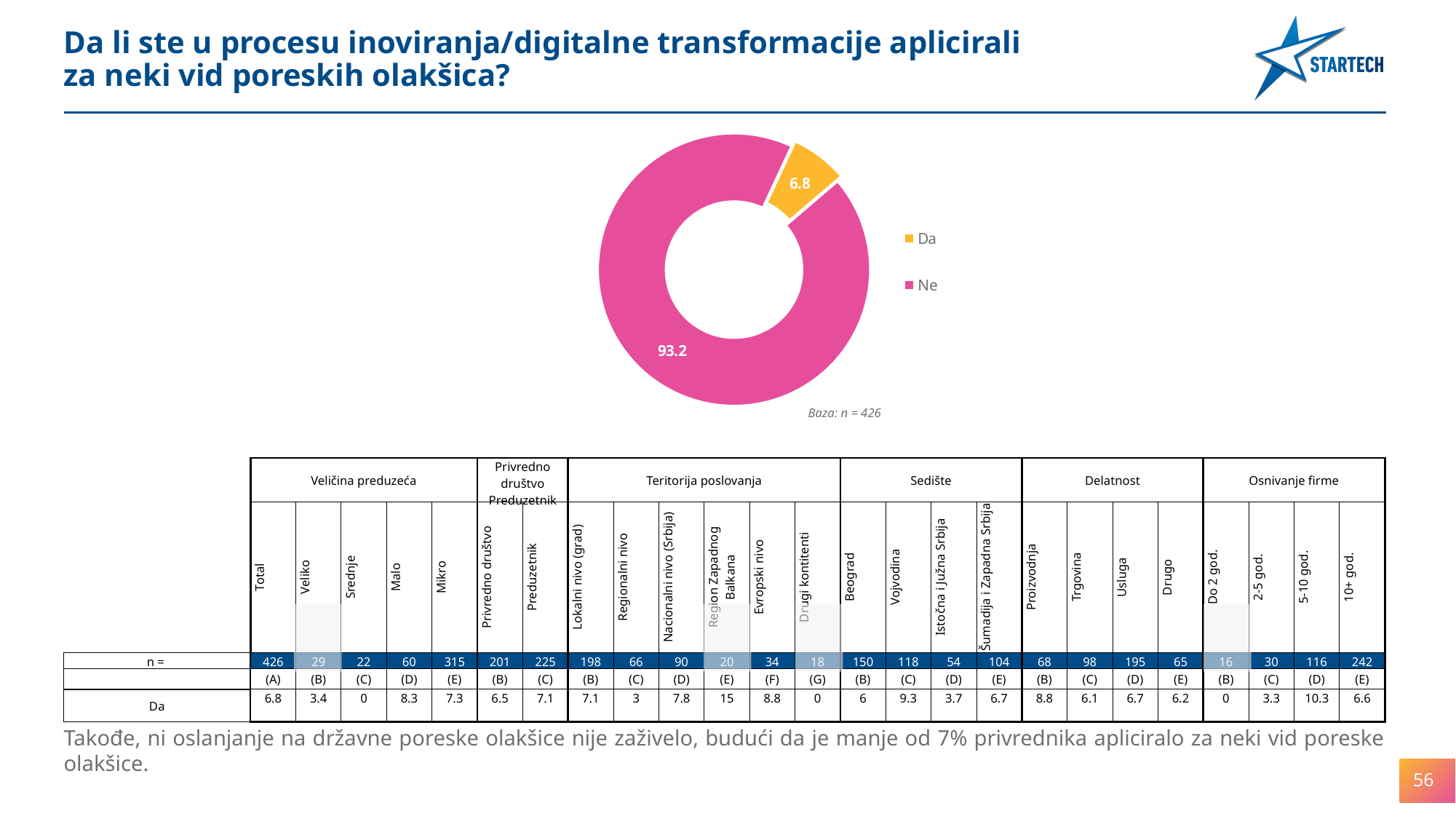
What value is shown for the "Da" slice of the donut chart? 6.8 How many entries does the legend of the donut chart list? 2 How many slices does the donut chart have? 2 What is the total of the two values shown in the donut chart? 100 Which slice of the donut chart is the largest? Ne Which slice of the donut chart is the smallest? Da What is the difference between the "Ne" and "Da" values in the donut chart? 86.4 What kind of chart is shown on the slide? Pie (donut) chart What value is shown for the "Ne" slice of the donut chart? 93.2 Which is larger in the donut chart, "Da" or "Ne"? Ne What base size (n) is stated below the donut chart? n = 426 What colour is the "Da" slice in the donut chart? Yellow/orange